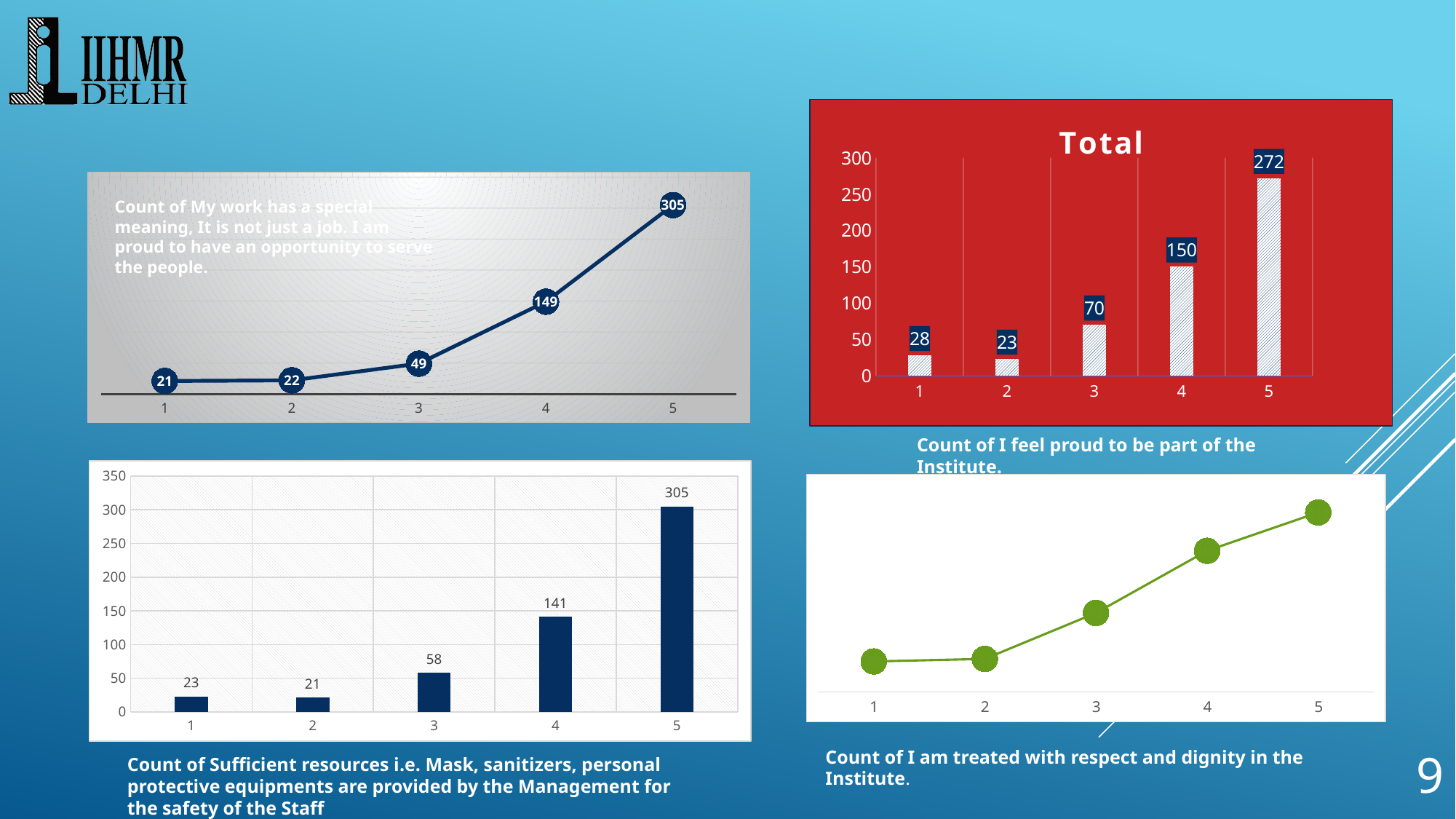
In the bottom-left bar chart (Count of Sufficient resources), what is the value for category 3? 58 In the bottom-right line chart (Count of I am treated with respect and dignity), do the values generally rise or fall from category 1 to category 5? rise In the top-left line chart (Count of My work has a special meaning), what is the value for category 5? 305 What kind of chart is the top-right chart titled Total? bar chart In the top-right chart titled Total, what is the value for category 4? 150 In the top-left line chart (Count of My work has a special meaning), which category has the lowest value? 1 In the top-right chart titled Total, which category has the lowest value? 2 In the top-left line chart (Count of My work has a special meaning), what is the value for category 3? 49 In the top-right chart titled Total, what is the difference between the values for category 5 and category 4? 122 In the bottom-left bar chart (Count of Sufficient resources), what is the difference between the values for category 4 and category 3? 83 In the bottom-left bar chart (Count of Sufficient resources), which category has the highest value? 5 How many data points are plotted in the bottom-right line chart (Count of I am treated with respect and dignity)? 5